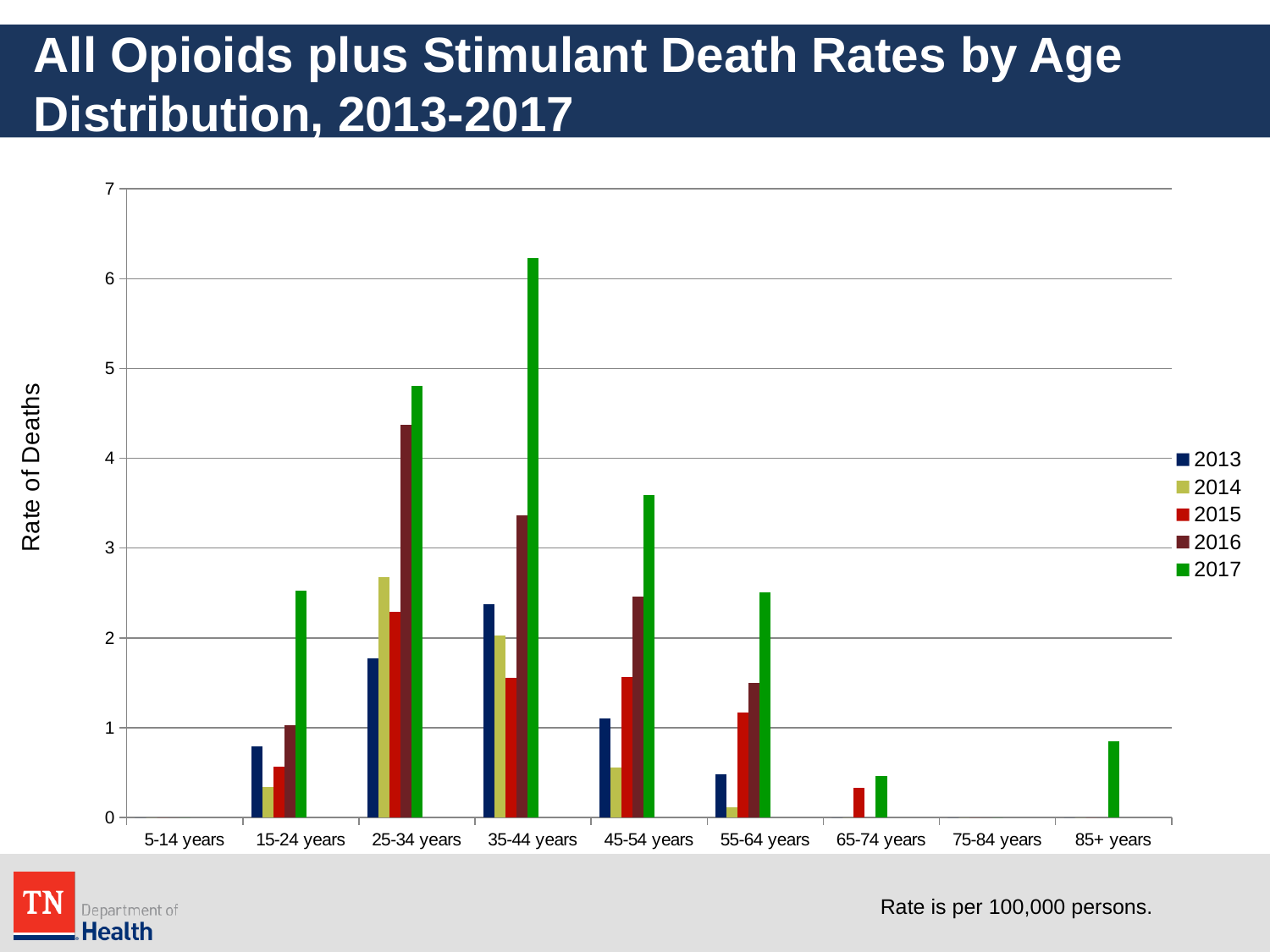
Is the 2013 value for 15-24 years greater or less than 1? less Is the 2017 value for 35-44 years greater or less than 6? greater Which age group has the highest 2017 death rate? 35-44 years Within the 45-54 years group, do the bars rise or fall from 2015 to 2017? rise Within the 25-34 years group, which is larger, the 2014 value or the 2015 value? 2014 What is the label on the y axis? Rate of Deaths Within the 55-64 years group, which year has the lowest death rate? 2014 How many series does the legend list? 5 Is the 2016 value for 25-34 years greater or less than 4? greater How many age groups are shown on the x axis? 9 What kind of chart is shown on the slide? bar chart Which is larger, the 2017 value for 25-34 years or the 2017 value for 45-54 years? 25-34 years